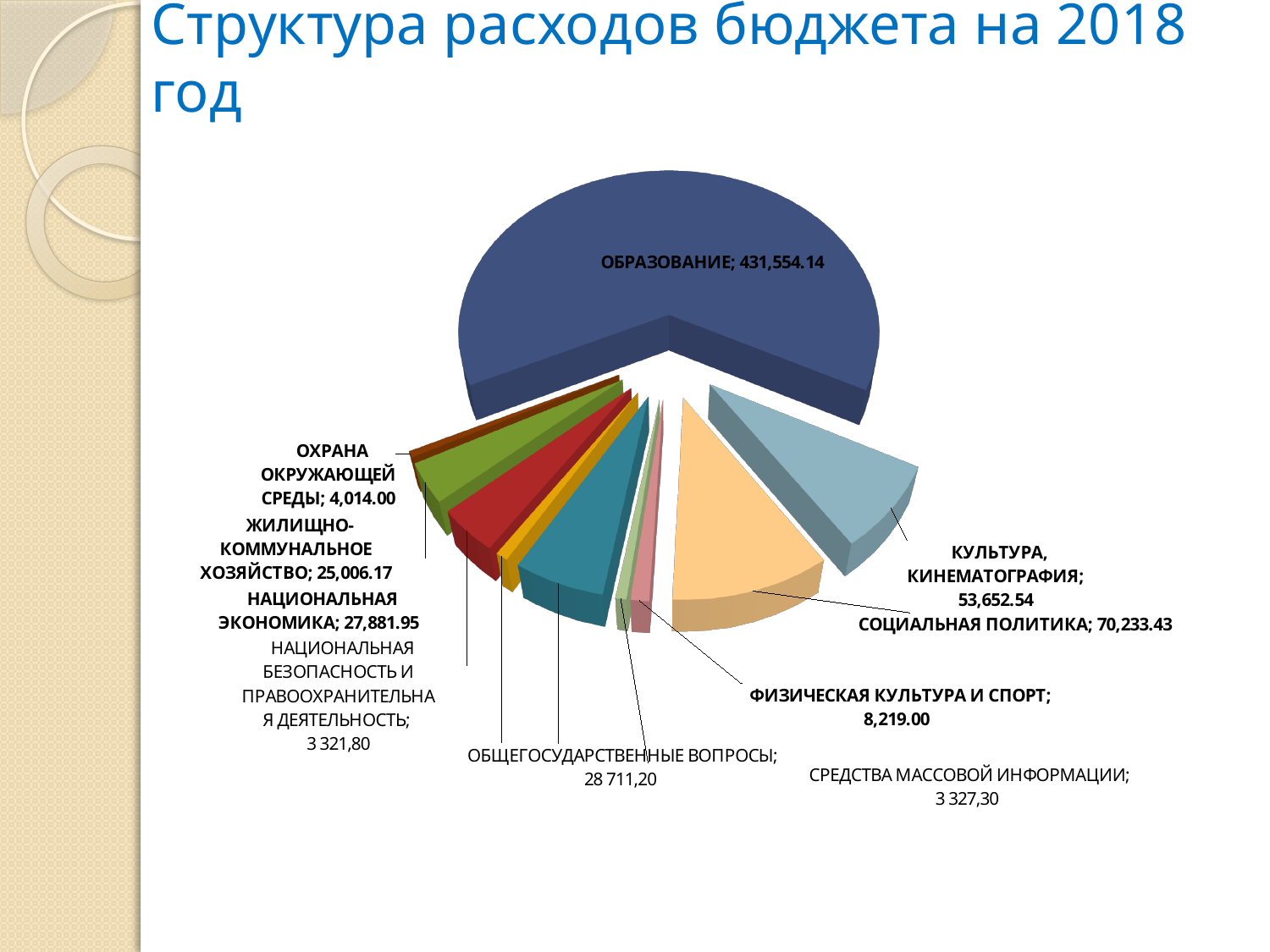
What is the value shown for КУЛЬТУРА, КИНЕМАТОГРАФИЯ? 53,652.54 What is the value shown for ОБЩЕГОСУДАРСТВЕННЫЕ ВОПРОСЫ? 28 711,20 What is the value shown for ОХРАНА ОКРУЖАЮЩЕЙ СРЕДЫ? 4,014.00 Which category has the largest slice of the pie? ОБРАЗОВАНИЕ What is the value shown for СОЦИАЛЬНАЯ ПОЛИТИКА? 70,233.43 How many categories are shown in the pie chart? 10 What is the difference between the values for СОЦИАЛЬНАЯ ПОЛИТИКА and КУЛЬТУРА, КИНЕМАТОГРАФИЯ? 16,580.89 What is the difference between the values for НАЦИОНАЛЬНАЯ ЭКОНОМИКА and ЖИЛИЩНО-КОММУНАЛЬНОЕ ХОЗЯЙСТВО? 2,875.78 What is the value shown for ОБРАЗОВАНИЕ? 431,554.14 What is the value shown for ФИЗИЧЕСКАЯ КУЛЬТУРА И СПОРТ? 8,219.00 What kind of chart is shown on the slide? Pie chart Which is larger, СОЦИАЛЬНАЯ ПОЛИТИКА or КУЛЬТУРА, КИНЕМАТОГРАФИЯ? СОЦИАЛЬНАЯ ПОЛИТИКА